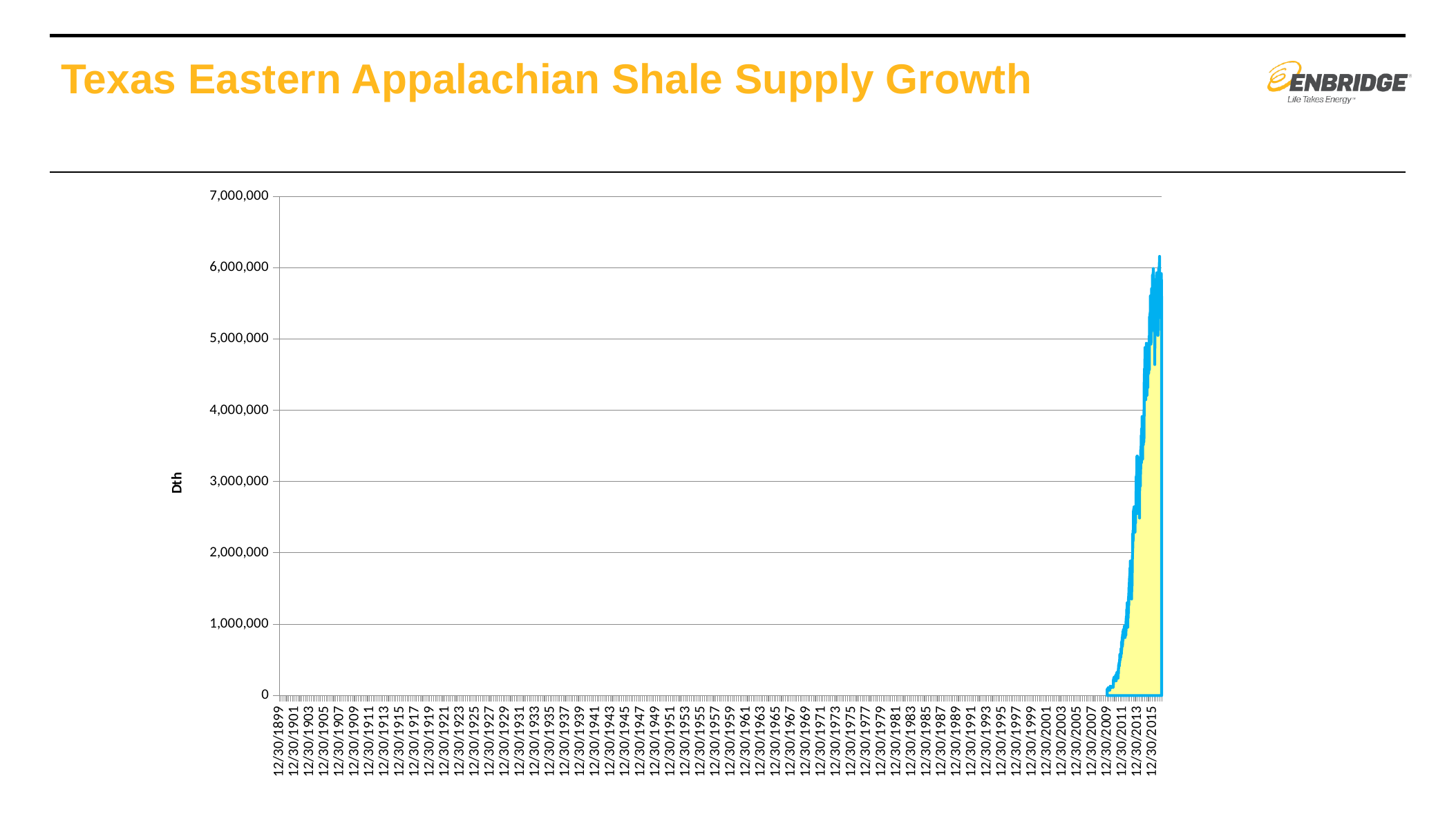
Is the peak value of the plotted series greater or less than 5,000,000? greater Is the value at 12/30/2015 greater or less than 4,000,000? greater Do the plotted values rise or fall between 12/30/2009 and 12/30/2015? rise What is the label on the vertical axis of the chart? Dth Is the value at 12/30/2013 greater or less than 2,000,000? greater What is the title of the chart? Texas Eastern Appalachian Shale Supply Growth What is the highest value shown on the vertical axis? 7,000,000 What kind of chart is shown on the slide? area chart What is the latest date label on the horizontal axis? 12/30/2015 What is the earliest date label on the horizontal axis? 12/30/1899